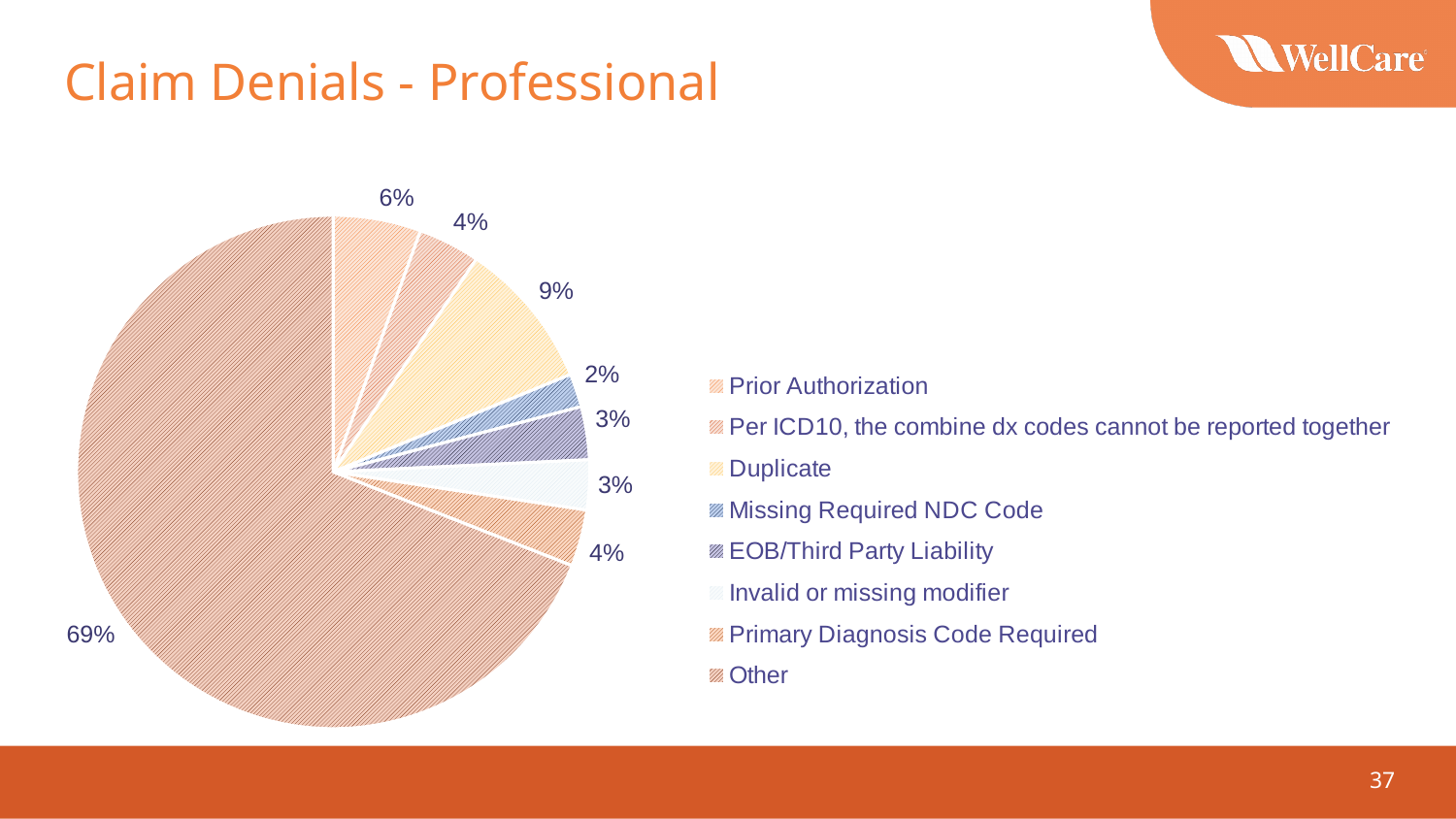
Which category has the largest slice of the pie chart? Other What is the last category listed in the legend? Other What percentage is shown for the Missing Required NDC Code slice? 2% What is the difference in percentage points between the Duplicate slice and the Missing Required NDC Code slice? 7 What percentage is shown for the Prior Authorization slice? 6% Which category has the smallest slice of the pie chart? Missing Required NDC Code What is the title of the chart on the slide? Claim Denials - Professional Which slice is larger, Duplicate or Prior Authorization? Duplicate How many categories does the legend of the pie chart list? 8 What percentage is shown for the Duplicate slice? 9% What share of the pie does the Other slice represent? 69% What kind of chart is shown on the slide? pie chart